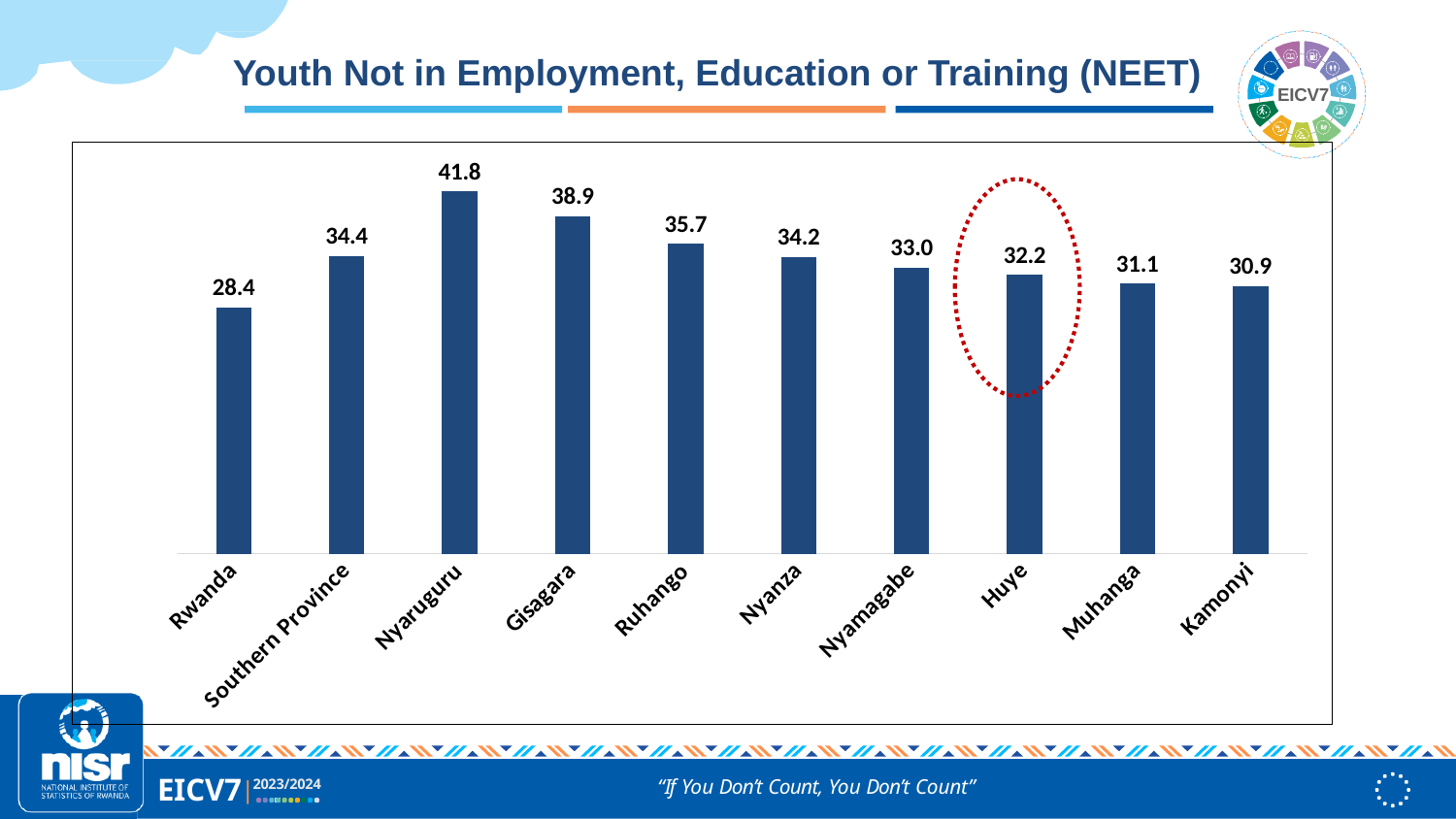
Which category has the lowest value? Rwanda What is the value for Huye? 32.2 Which category has the highest value? Nyaruguru What is the value for Rwanda? 28.4 What is the value for Nyaruguru? 41.8 Which is larger, the value for Muhanga or the value for Nyamagabe? Nyamagabe What is the difference between the values for Nyaruguru and Rwanda? 13.4 How many categories are shown on the x axis? 10 Which is larger, the value for Gisagara or the value for Ruhango? Gisagara Which category is highlighted with a red dotted circle? Huye What is the difference between the values for Southern Province and Huye? 2.2 What kind of chart is shown on the slide? Bar chart